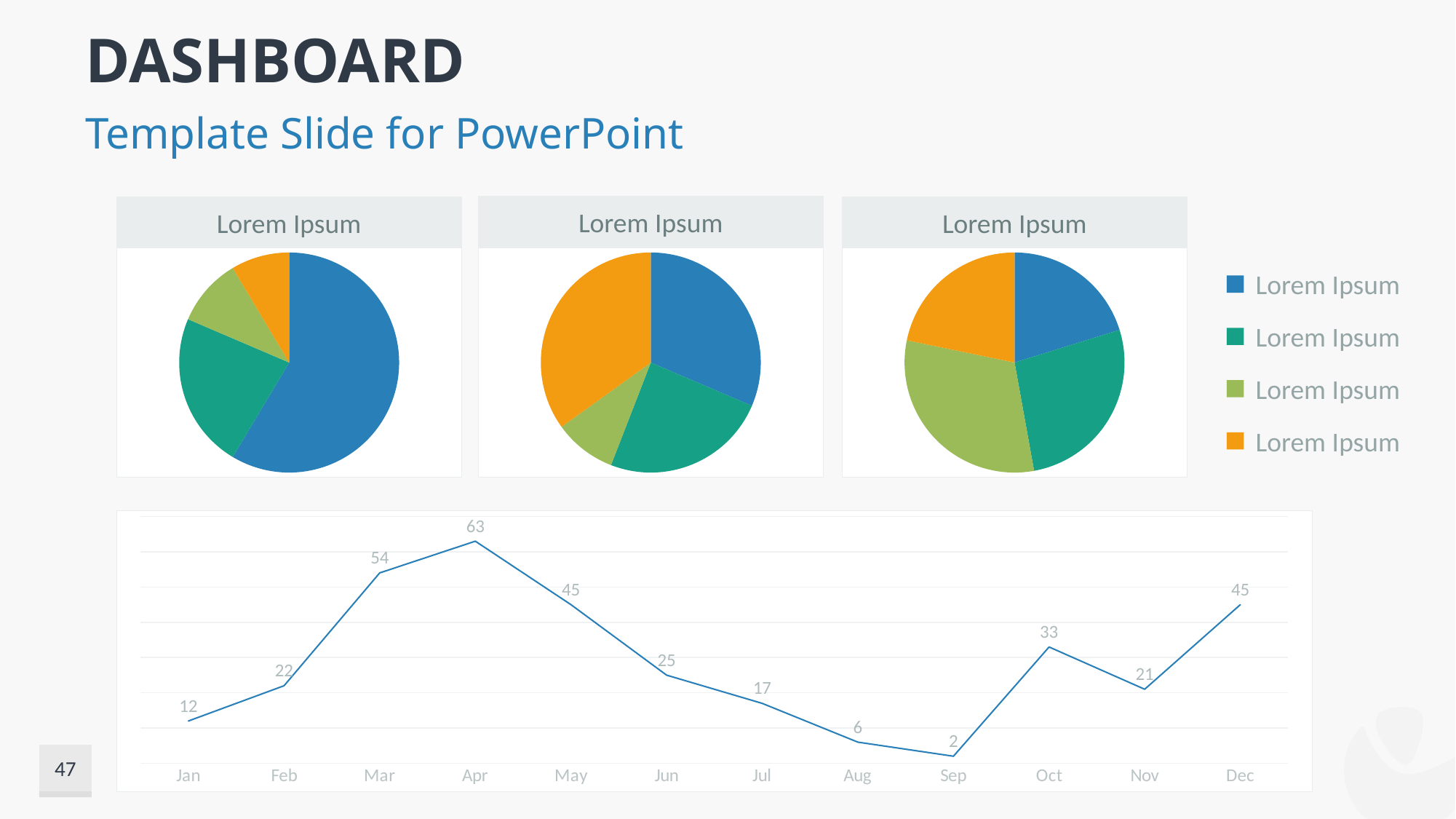
In the bottom line chart, what is the value for Oct? 33 How many entries does the legend next to the pie charts list? 4 In the bottom line chart, what is the value for Sep? 2 In the bottom line chart, which month has the highest value? Apr How many months are plotted in the bottom line chart? 12 In the bottom line chart, what is the difference between the values for Apr and Mar? 9 In the bottom line chart, what is the value for Apr? 63 What type of chart is shown at the bottom of the slide? Line chart In the bottom line chart, which month has the lowest value? Sep In the bottom line chart, which is larger, the value for Jun or the value for Nov? Jun In the leftmost pie chart, which colour slice is the largest? Blue In the bottom line chart, do the values rise or fall from Apr to Sep? Fall